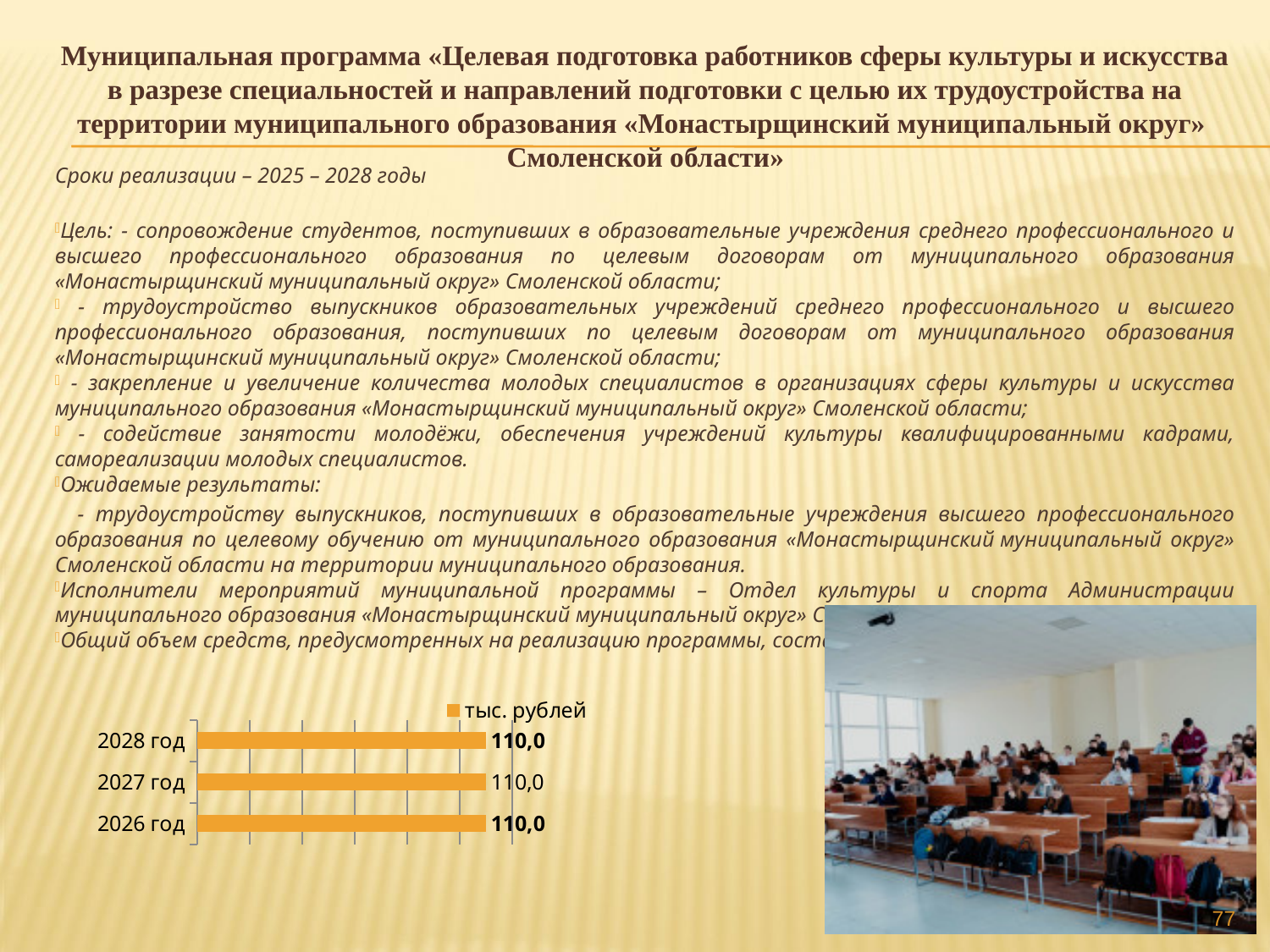
What is the difference between the values for 2028 год and 2026 год? 0,0 What is the legend entry of the series in the chart? тыс. рублей How many series does the legend list? 1 What is the value for 2027 год? 110,0 What is the value for 2028 год? 110,0 What kind of chart is shown on the slide? bar chart Is the value for 2027 год larger or smaller than the value for 2026 год? They are equal What colour are the bars in the chart? Orange Do the values change from 2026 год to 2028 год? No, they stay the same What is the value for 2026 год? 110,0 How many categories (years) are shown in the chart? 3